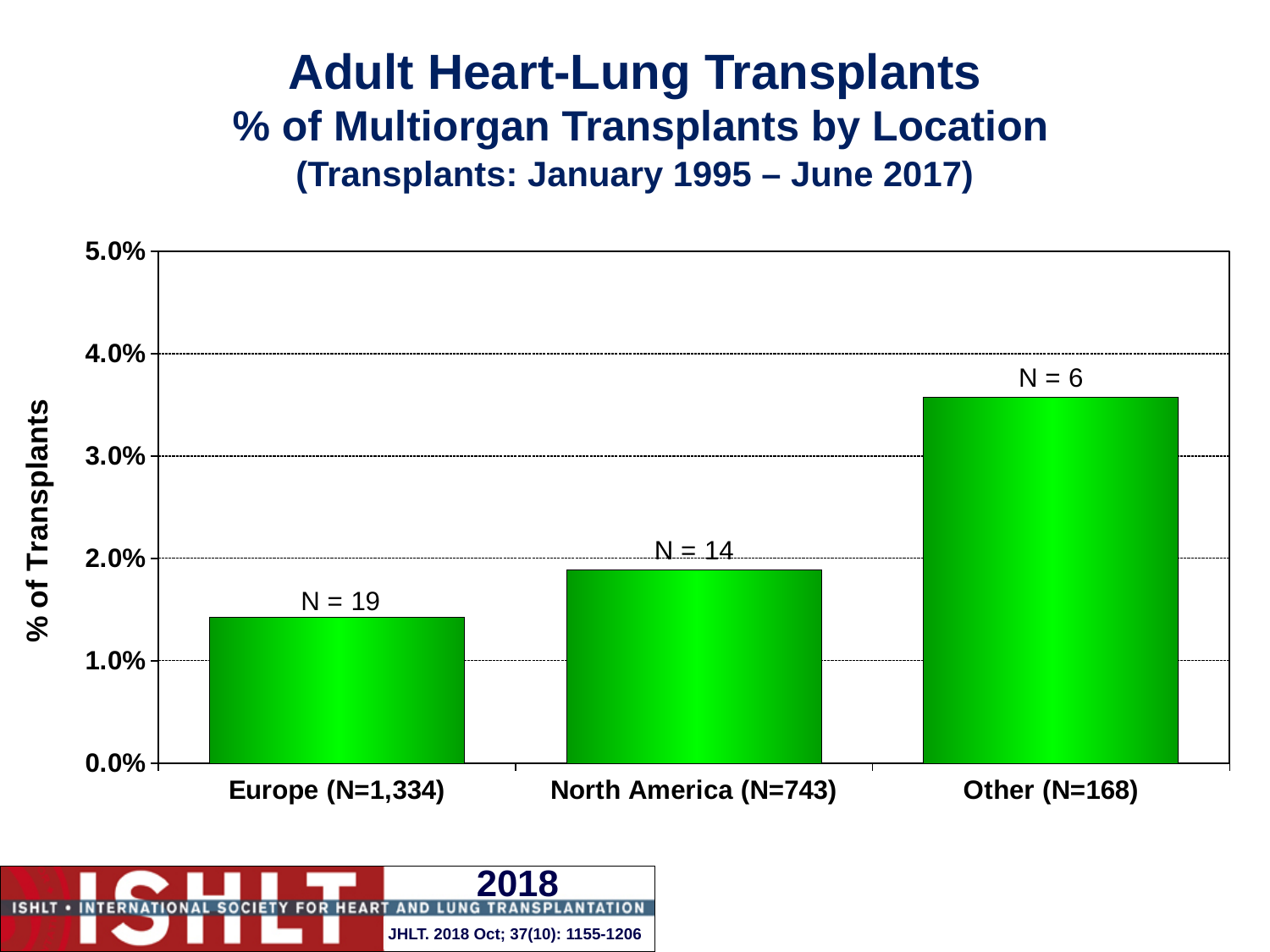
What is the N value printed above the North America bar? N = 14 Is the value for North America (N=743) greater or less than 1.0%? greater Which location has the highest % of transplants? Other (N=168) Is the value for Other (N=168) greater or less than 3.0%? greater What is the N value printed above the Europe bar? N = 19 How many location categories are shown on the x axis? 3 What is the N value printed above the Other bar? N = 6 Which location has the lowest % of transplants? Europe (N=1,334) What kind of chart is shown on the slide? bar chart Do the bar values rise or fall from left to right across the x axis? rise Is the value for Europe (N=1,334) greater or less than 2.0%? less Which is larger, the % of transplants for Other (N=168) or for North America (N=743)? Other (N=168)